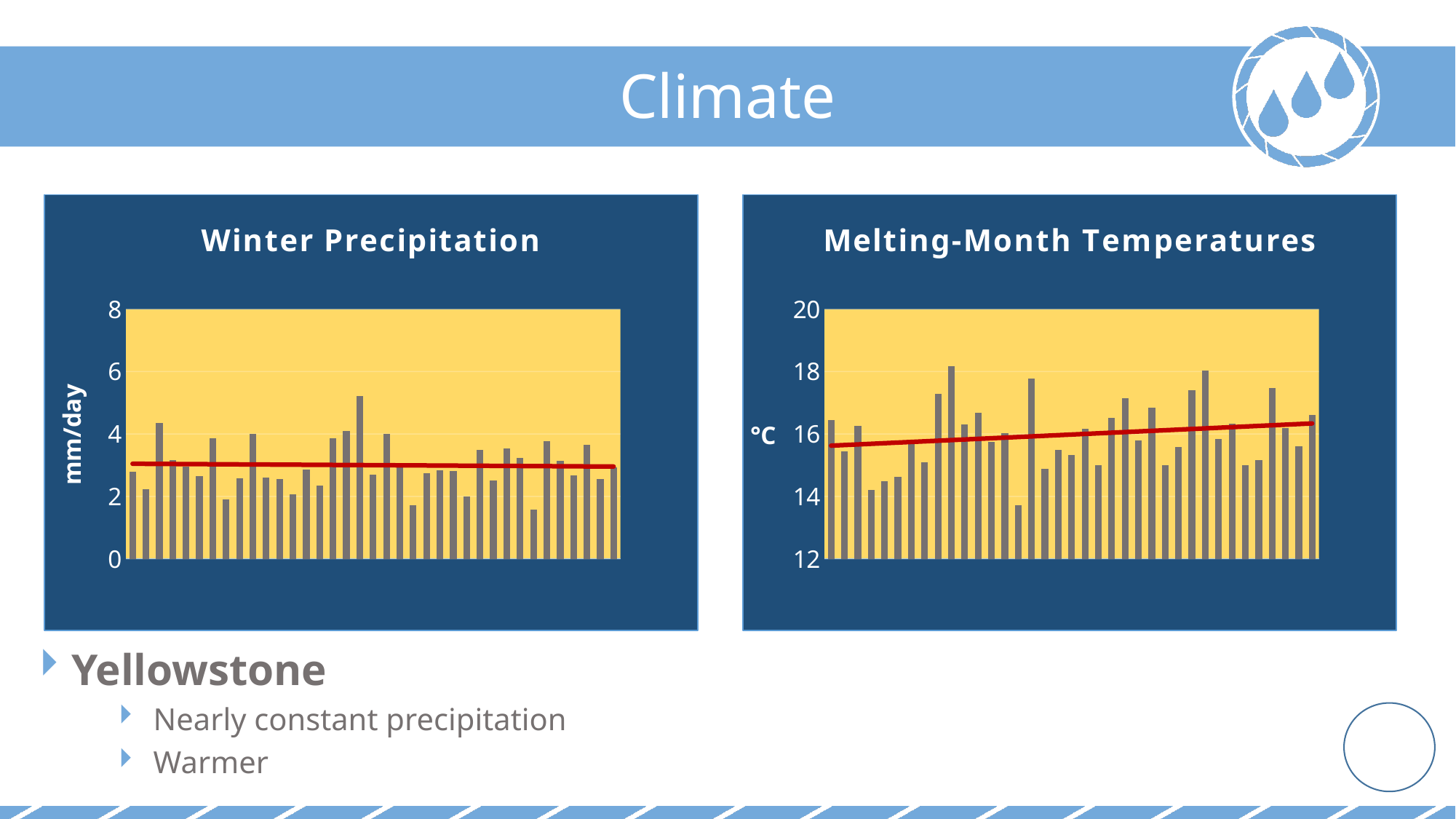
In the Winter Precipitation chart, does the red trend line rise noticeably, fall noticeably, or stay nearly flat from left to right? Nearly flat In the Melting-Month Temperatures chart, is the tallest bar greater or less than 17? greater What unit is shown on the y-axis of the Winter Precipitation chart? mm/day What unit is shown on the y-axis of the Melting-Month Temperatures chart? °C What kind of chart is the Melting-Month Temperatures chart? Bar chart In the Winter Precipitation chart, is the tallest bar greater or less than 4? greater In the Melting-Month Temperatures chart, does the red trend line rise or fall from left to right? Rise In the Melting-Month Temperatures chart, is the shortest bar greater or less than 14? less What kind of chart is the Winter Precipitation chart? Bar chart